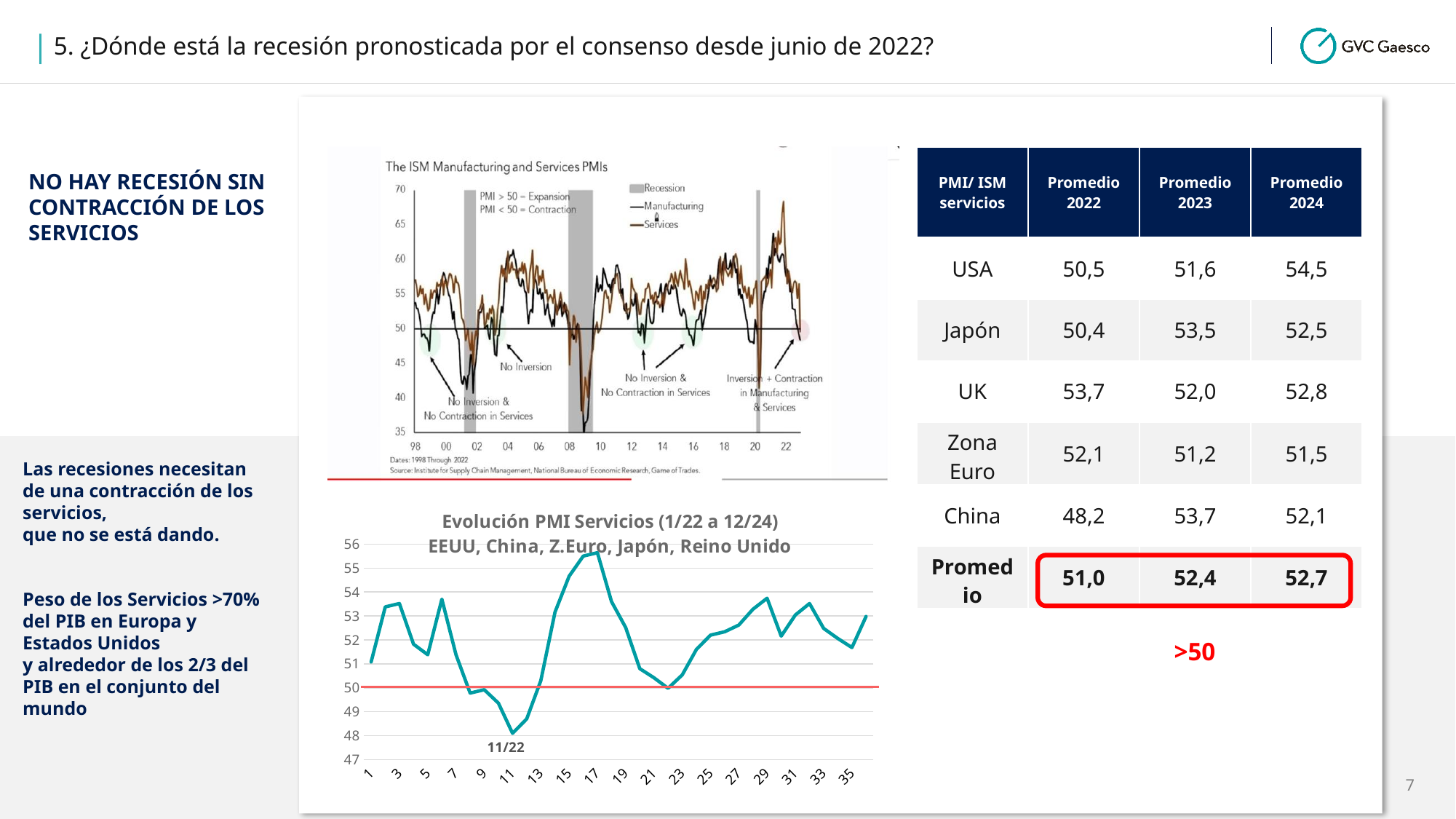
In the top chart 'The ISM Manufacturing and Services PMIs', what is the lowest value shown on the vertical axis? 35 In the bottom chart 'Evolución PMI Servicios', which point is the lowest, point 11 or point 17? Point 11 In the bottom chart 'Evolución PMI Servicios', is the value at point 17 greater or less than 55? greater In the top chart 'The ISM Manufacturing and Services PMIs', how many line series does the legend list? 2 In the bottom chart 'Evolución PMI Servicios', is the value at point 29 greater or less than 53? greater What kind of chart is the top chart 'The ISM Manufacturing and Services PMIs'? Line chart In the bottom chart 'Evolución PMI Servicios', what is the highest value shown on the vertical axis? 56 In the bottom chart 'Evolución PMI Servicios', is the value at point 33 greater or less than 52? greater What is the title of the top chart on the slide? The ISM Manufacturing and Services PMIs What kind of chart is the bottom chart titled 'Evolución PMI Servicios (1/22 a 12/24)'? Line chart